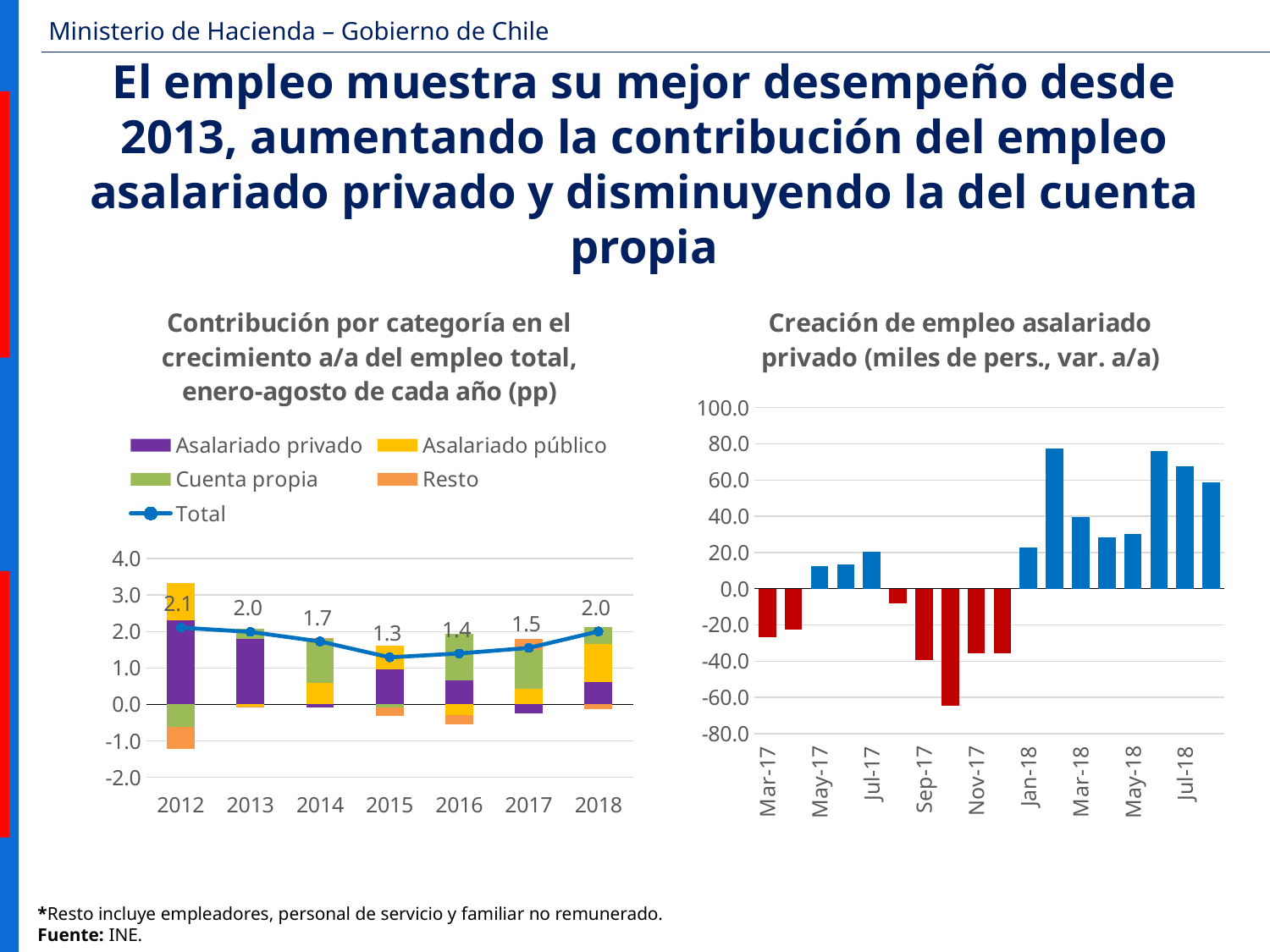
In the right chart (Creación de empleo asalariado privado), is the value for Sep-17 greater or less than -20? less In the left chart (Contribución por categoría), which year has the lowest Total value? 2015 In the right chart (Creación de empleo asalariado privado), is the value for Jul-18 greater or less than 60? greater In the left chart (Contribución por categoría), how many years are shown on the x axis? 7 In the left chart (Contribución por categoría), what is the difference between the Total values for 2012 and 2015? 0.8 What kind of chart is the right chart (Creación de empleo asalariado privado)? bar chart In the left chart (Contribución por categoría), is the Total value higher in 2014 or in 2017? 2014 In the left chart (Contribución por categoría), which year has the highest Total value? 2012 In the left chart (Contribución por categoría), what is the Total value for 2015? 1.3 In the left chart (Contribución por categoría), what is the Total value for 2012? 2.1 In the left chart (Contribución por categoría), how many entries does the legend list? 5 In the left chart (Contribución por categoría), does the Total line rise or fall from 2015 to 2018? rise